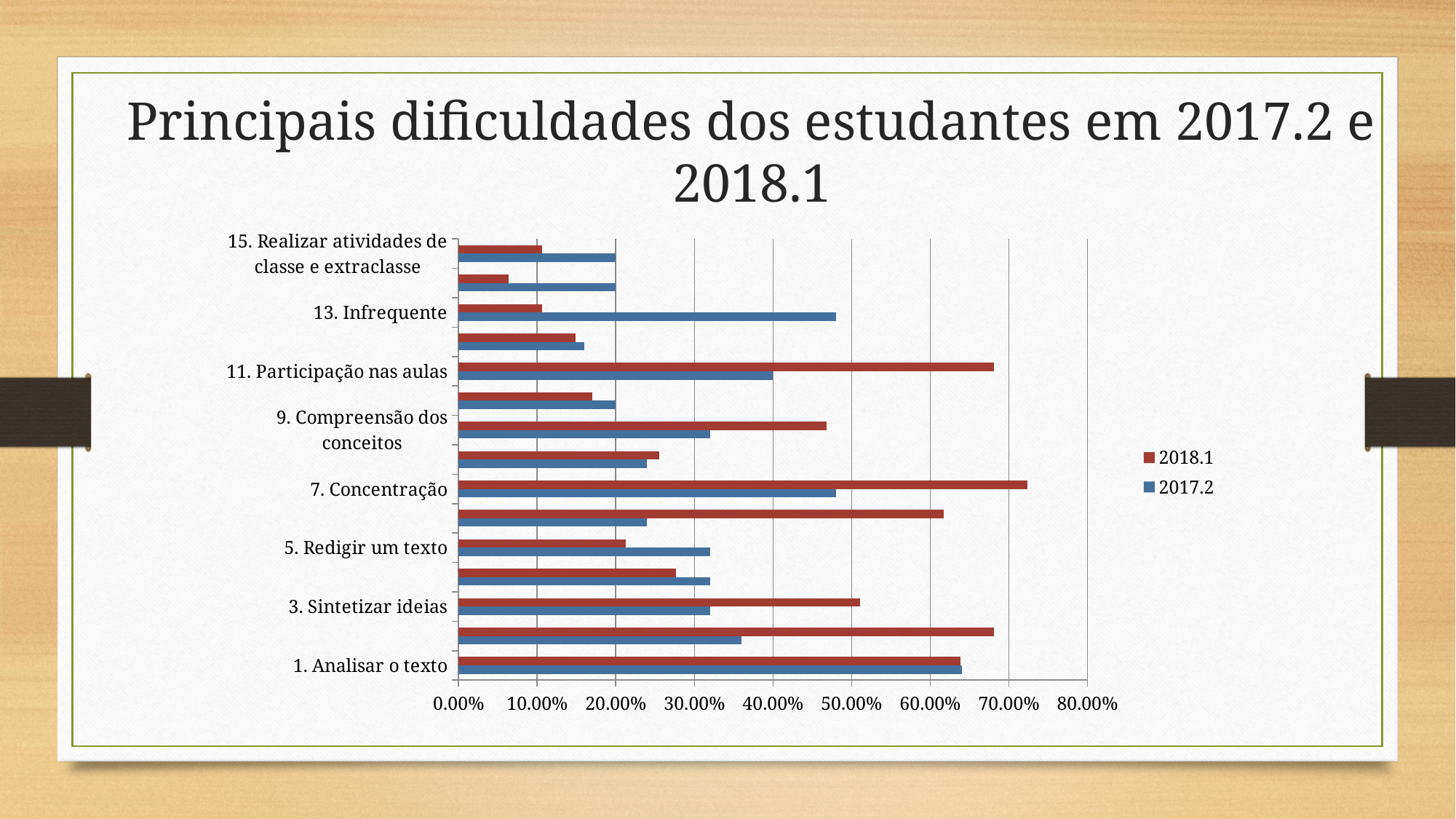
Is the 2017.2 value for 13. Infrequente greater or less than 40.00%? greater For 13. Infrequente, which series has the larger value, 2018.1 or 2017.2? 2017.2 Is the 2018.1 value for 15. Realizar atividades de classe e extraclasse greater or less than 20.00%? less What kind of chart is shown on the slide? Bar chart Which series is shown in red in the legend? 2018.1 Is the 2018.1 value for 13. Infrequente greater or less than 20.00%? less How many series does the legend list? 2 Which category has the highest value for the 2018.1 series? 7. Concentração For 5. Redigir um texto, which series has the larger value, 2018.1 or 2017.2? 2017.2 Which category has the highest value for the 2017.2 series? 1. Analisar o texto